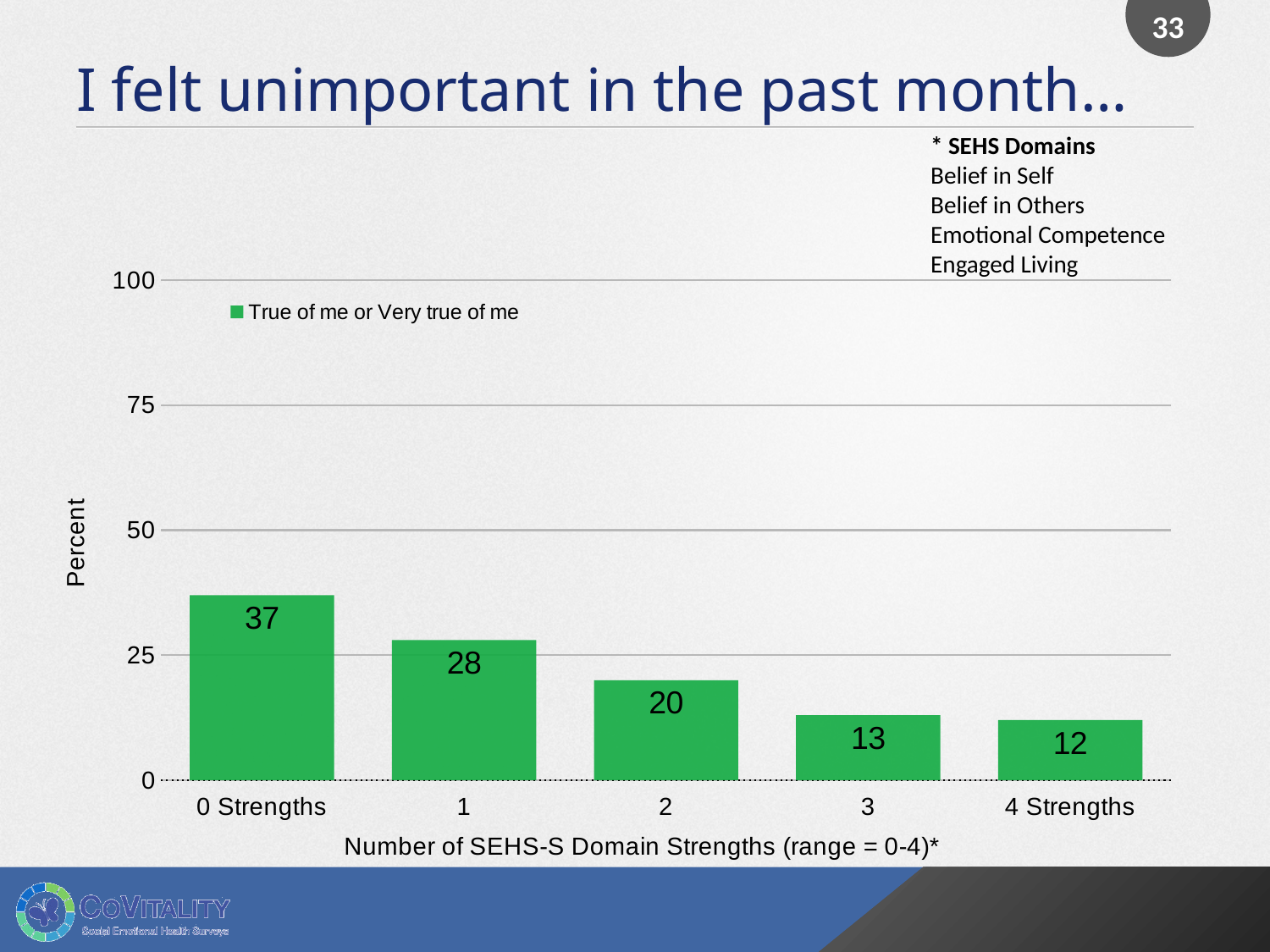
What kind of chart is shown on the slide? bar chart What is the value for 4 Strengths? 12 Which is larger, the value for 1 strength or the value for 3 strengths? 1 Which category has the highest value? 0 Strengths How many categories are shown on the x axis? 5 Do the values rise or fall as the number of domain strengths increases? fall What is the difference between the values for 0 Strengths and 4 Strengths? 25 Is the value for 0 Strengths greater or less than 25? greater What is the value for 0 Strengths? 37 What is the value for 2 domain strengths? 20 What is the difference between the values for 1 and 2 domain strengths? 8 Which category has the lowest value? 4 Strengths